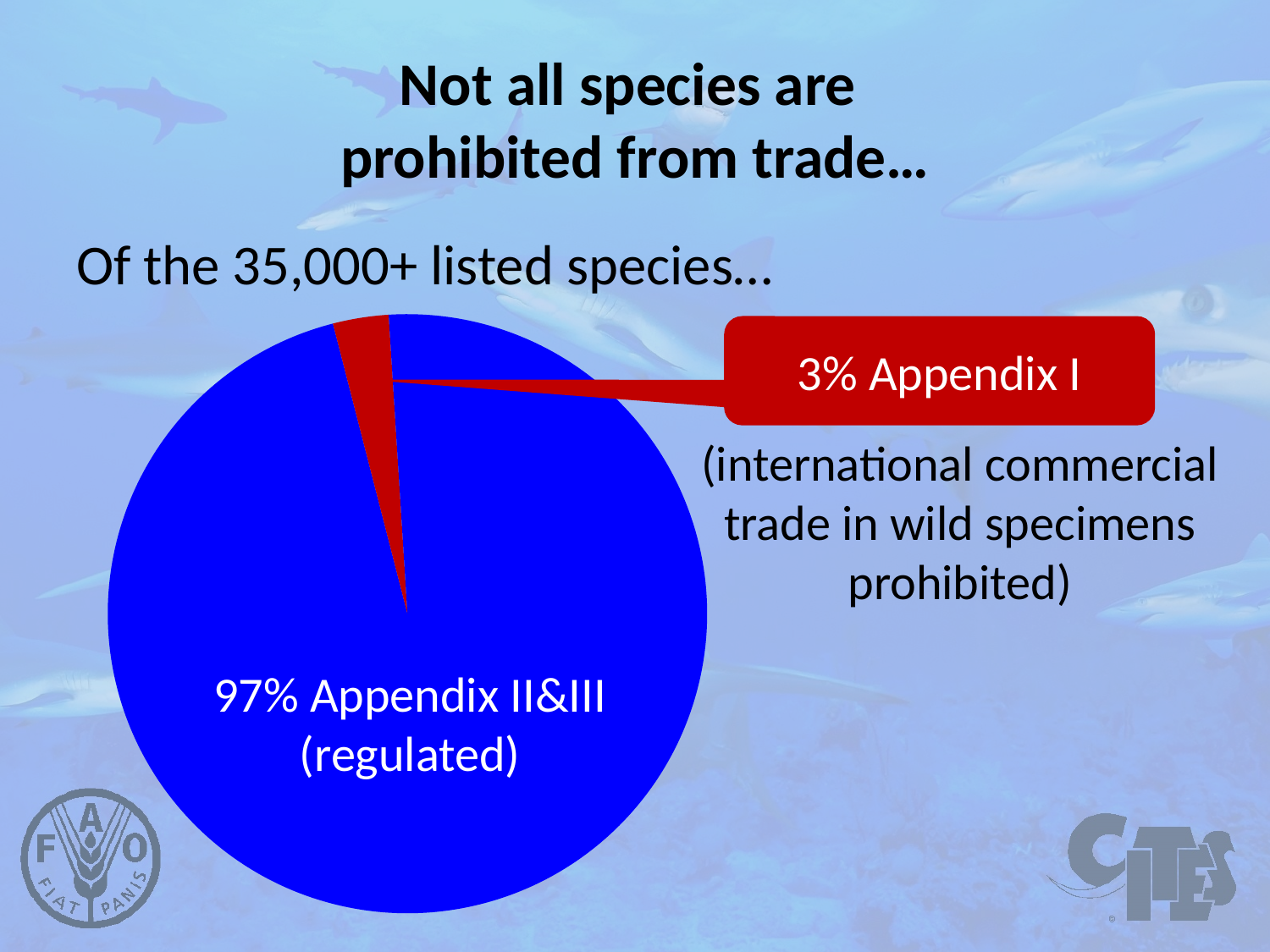
Is the Appendix I share greater or less than 10%? less Which is larger, the Appendix I share or the Appendix II&III share? Appendix II&III What colour is the Appendix I slice? red What kind of chart is shown on the slide? pie chart Which slice of the pie is the largest? Appendix II&III (regulated) How many slices does the pie chart have? 2 What colour is the Appendix II&III slice? blue What is the difference in percentage points between the Appendix II&III share and the Appendix I share? 94 Which slice of the pie is the smallest? Appendix I What do the two slices of the pie add up to? 100% What share of the listed species is in Appendix II&III? 97% What share of the listed species is in Appendix I? 3%